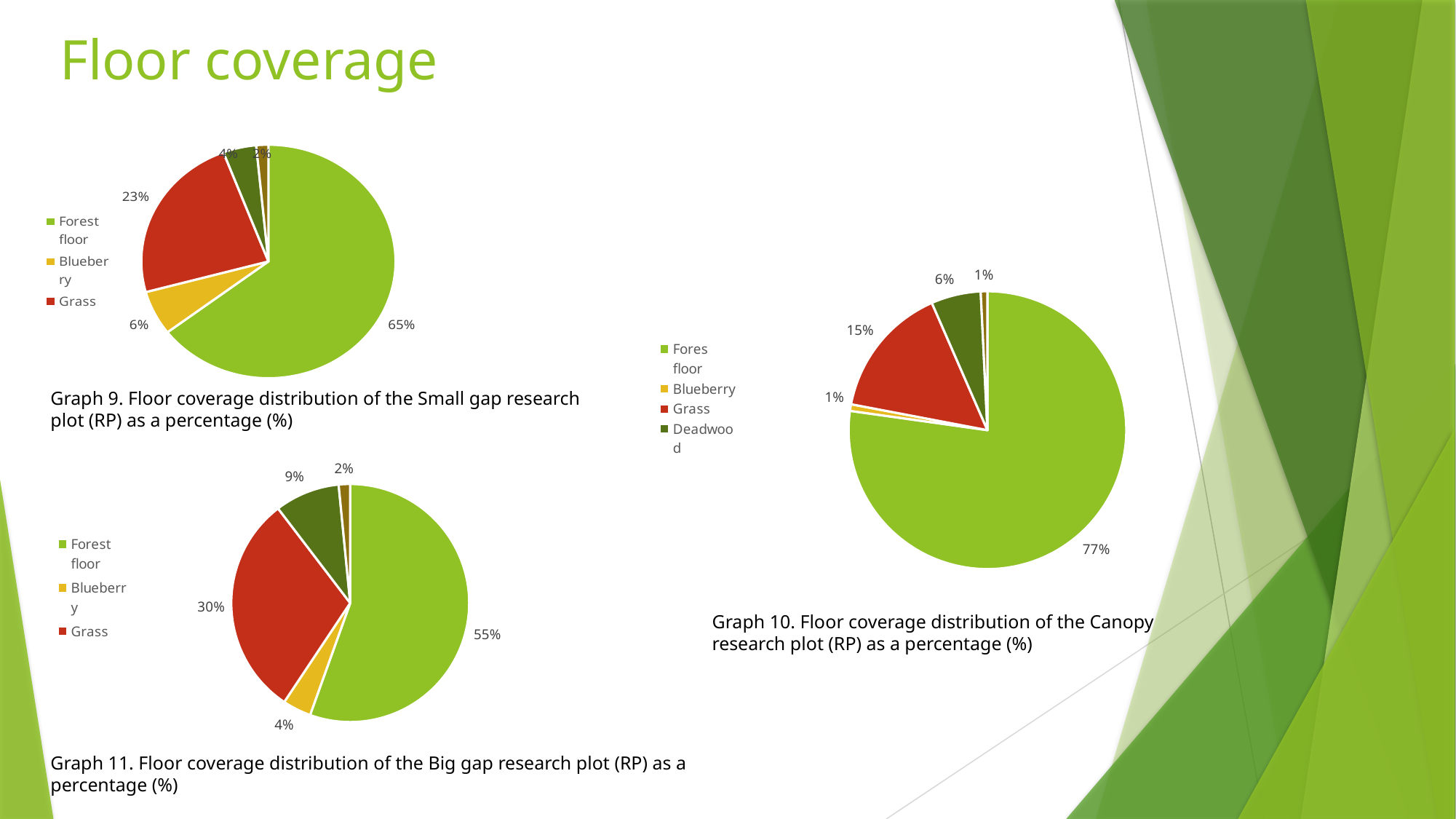
In Graph 10 (Canopy research plot), is the Grass share larger or smaller than the Deadwood share? larger In Graph 11 (Big gap research plot), which category has the largest share? Forest floor What type of chart is Graph 10 (Canopy research plot)? Pie chart In Graph 10 (Canopy research plot), what percentage is Forest floor? 77% In Graph 9 (Small gap research plot), what percentage is Forest floor? 65% In Graph 10 (Canopy research plot), what percentage is Deadwood? 6% In Graph 11 (Big gap research plot), what percentage is Blueberry? 4% In Graph 9 (Small gap research plot), what percentage is Grass? 23% In Graph 10 (Canopy research plot), what percentage is Grass? 15% In Graph 11 (Big gap research plot), what is the difference between the Forest floor and Grass shares? 25% In Graph 9 (Small gap research plot), what percentage is Blueberry? 6% In Graph 11 (Big gap research plot), what percentage is Grass? 30%